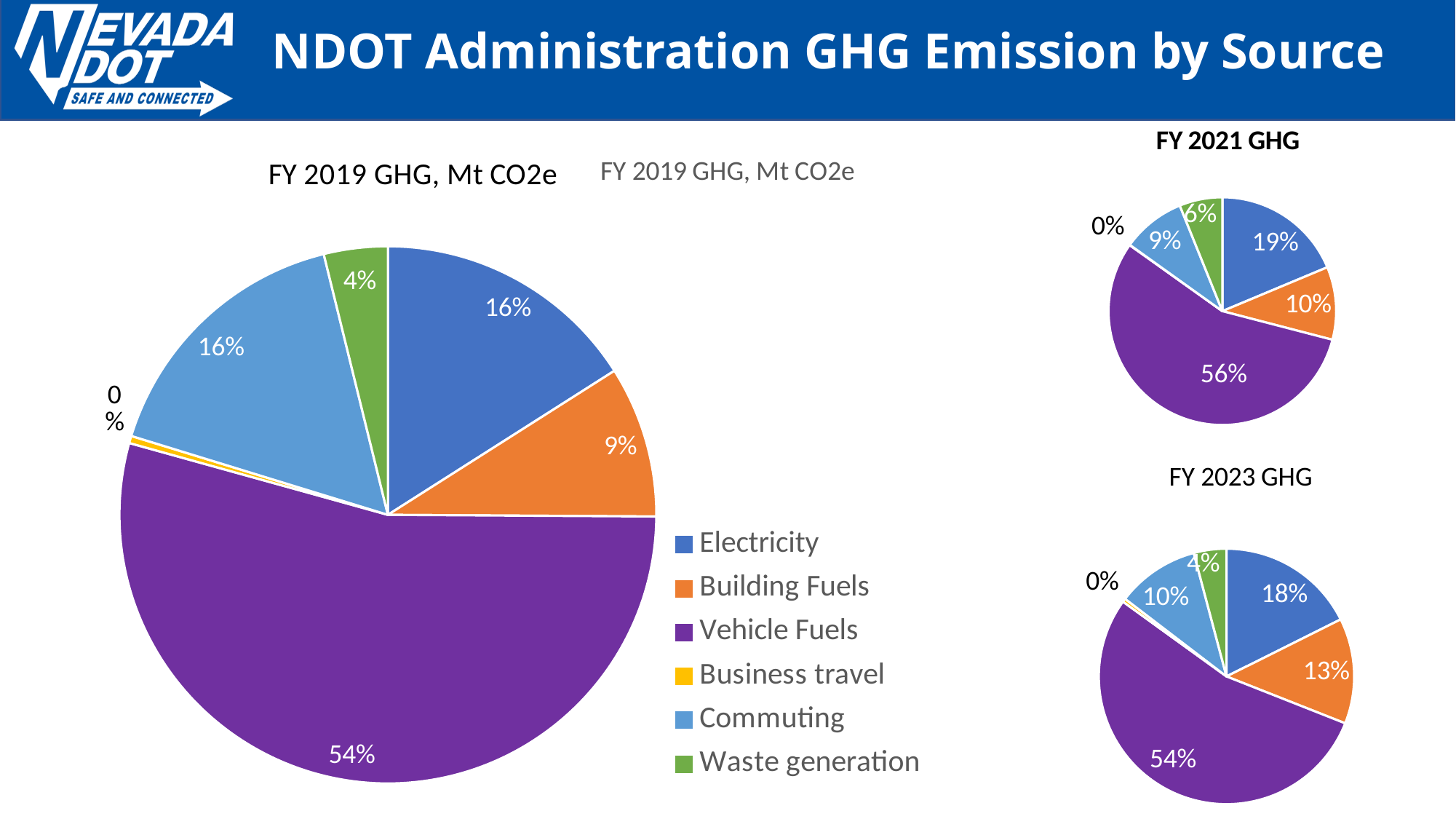
In the FY 2019 GHG, Mt CO2e pie chart, which source has the largest share? Vehicle Fuels In the FY 2023 GHG pie chart, what share of emissions comes from Building Fuels? 13% In the FY 2019 GHG, Mt CO2e pie chart, what share of emissions comes from Waste generation? 4% In the FY 2019 GHG, Mt CO2e pie chart, what share of emissions comes from Vehicle Fuels? 54% In the FY 2023 GHG pie chart, what is the difference between the Electricity share and the Commuting share? 8% Which colour represents Commuting in the legend? Light blue In the FY 2021 GHG pie chart, which is larger, the Commuting share or the Waste generation share? Commuting In the FY 2021 GHG pie chart, which source has the smallest share? Business travel What kind of chart is used to show the FY 2023 GHG data? Pie chart How many emission sources does the legend list? 6